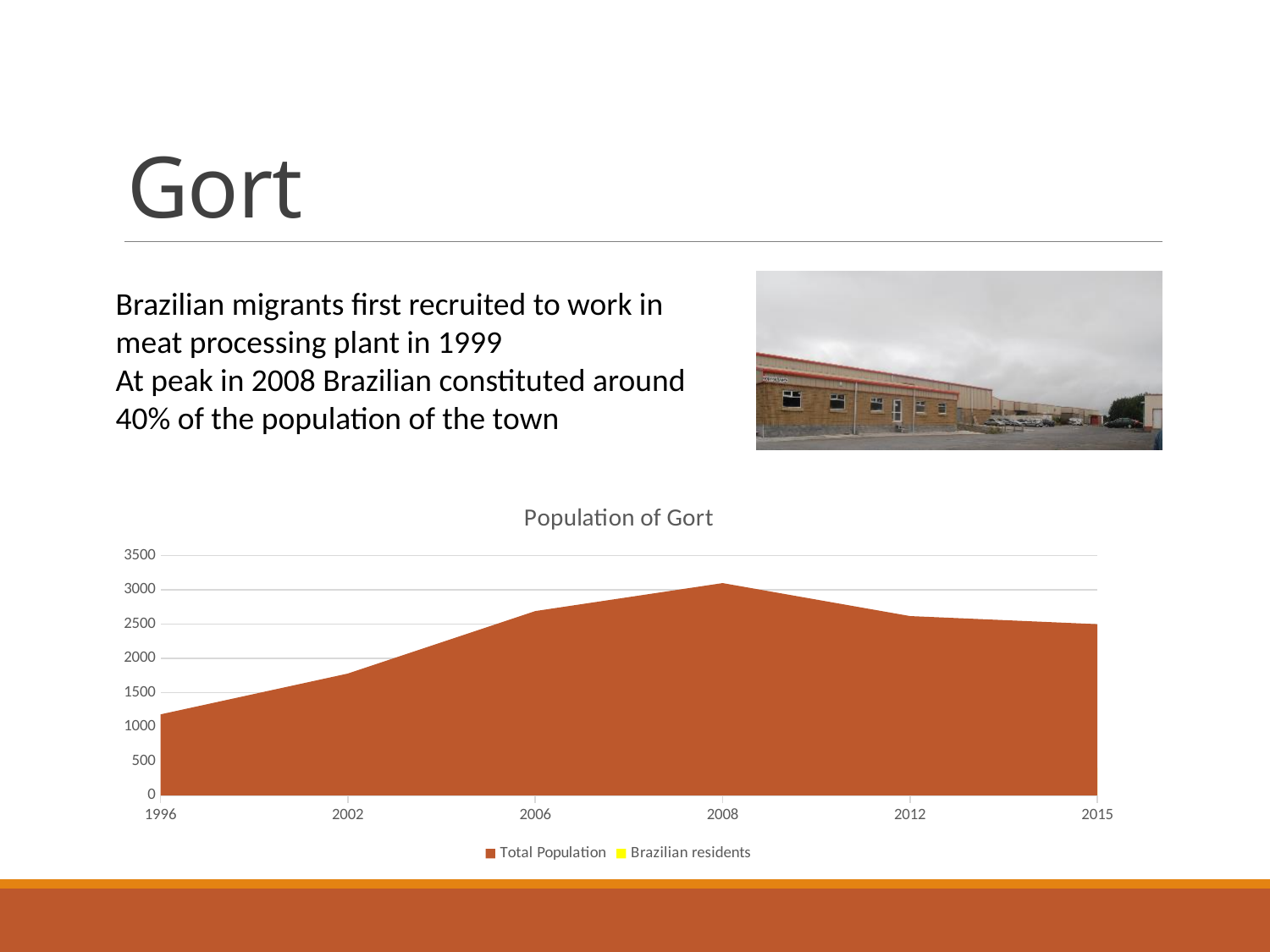
Is the Total Population value for 2002 greater or less than 2000? less Which year has the larger Total Population, 2002 or 2006? 2006 What is the title of the chart? Population of Gort What kind of chart is shown on the slide? area chart In which year is the Total Population of Gort lowest? 1996 How many years are labelled on the x axis of the chart? 6 In which year is the Total Population of Gort highest? 2008 Is the Total Population value for 2006 greater or less than 2500? greater Is the Total Population value for 2015 greater or less than 3000? less Does the Total Population rise or fall between 2008 and 2015? fall How many series does the chart legend list? 2